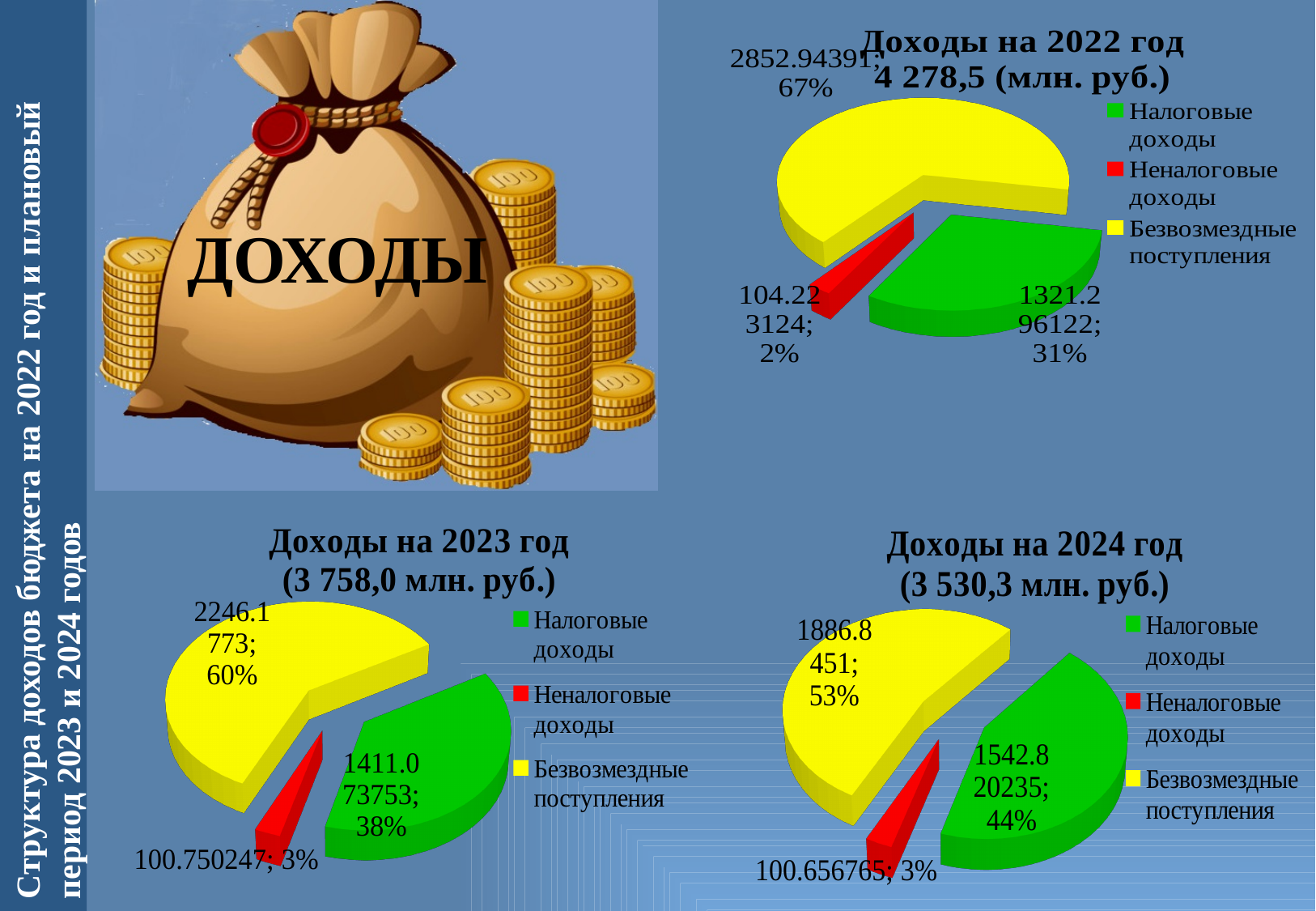
In the chart 'Доходы на 2023 год', which category has the largest slice? Безвозмездные поступления In the chart 'Доходы на 2022 год', what colour represents Неналоговые доходы? Red In the chart 'Доходы на 2022 год', what share of the pie is Безвозмездные поступления? 67% What kind of chart is 'Доходы на 2023 год'? Pie chart In the chart 'Доходы на 2023 год', what is the value for Неналоговые доходы? 100.750247 In the chart 'Доходы на 2024 год', what share of the pie is Безвозмездные поступления? 53% In the chart 'Доходы на 2022 год', which category has the smallest slice? Неналоговые доходы In the chart 'Доходы на 2024 год', what is the value for Налоговые доходы? 1542.820235 In the chart 'Доходы на 2024 год', which is larger, Налоговые доходы or Безвозмездные поступления? Безвозмездные поступления In the chart 'Доходы на 2023 год', what share of the pie is Налоговые доходы? 38% In the chart 'Доходы на 2022 год', what is the value for Налоговые доходы? 1321.296122 How many categories does the legend of the chart 'Доходы на 2024 год' list? 3